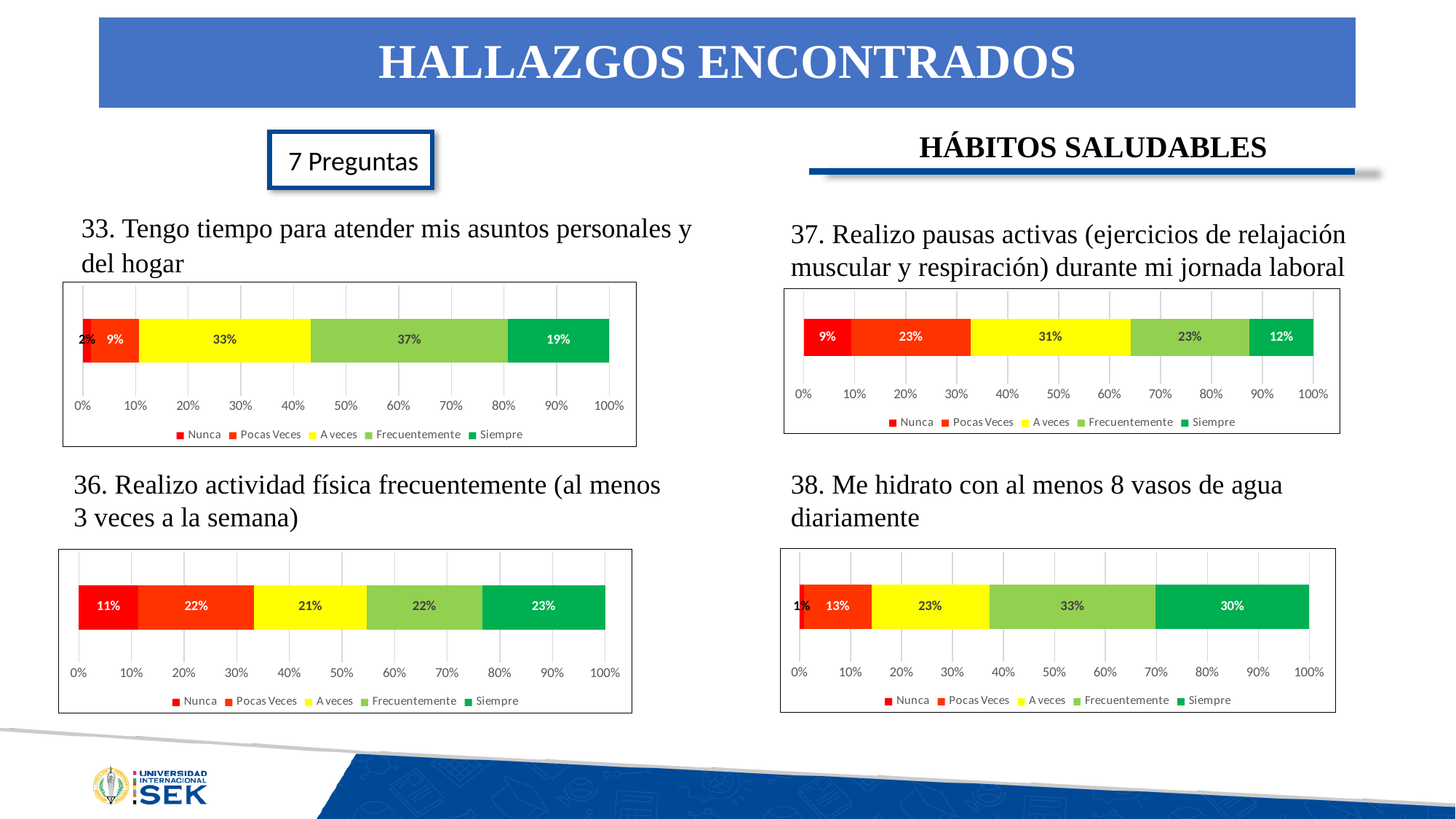
In the chart for question 33 (top left), which response category has the lowest percentage? Nunca What type of chart is used for question 37 (top right)? Stacked bar chart In the chart for question 37 (top right), what is the difference between the 'Pocas Veces' and 'Siempre' percentages? 11% In the chart for question 38 (bottom right), which response category has the highest percentage? Frecuentemente How many series does the legend list in the chart for question 36 (bottom left)? 5 In the chart for question 33 (top left), what percentage is shown for 'Frecuentemente'? 37% In the chart for question 37 (top right), what percentage is shown for 'A veces'? 31% In the chart for question 36 (bottom left), what percentage is shown for 'Nunca'? 11% In the chart for question 38 (bottom right), what is the difference between the 'Frecuentemente' and 'Pocas Veces' percentages? 20% In the chart for question 33 (top left), which response category has the highest percentage? Frecuentemente In the chart for question 38 (bottom right), what percentage is shown for 'Siempre'? 30% In the chart for question 36 (bottom left), which is larger, the 'Siempre' segment or the 'A veces' segment? Siempre